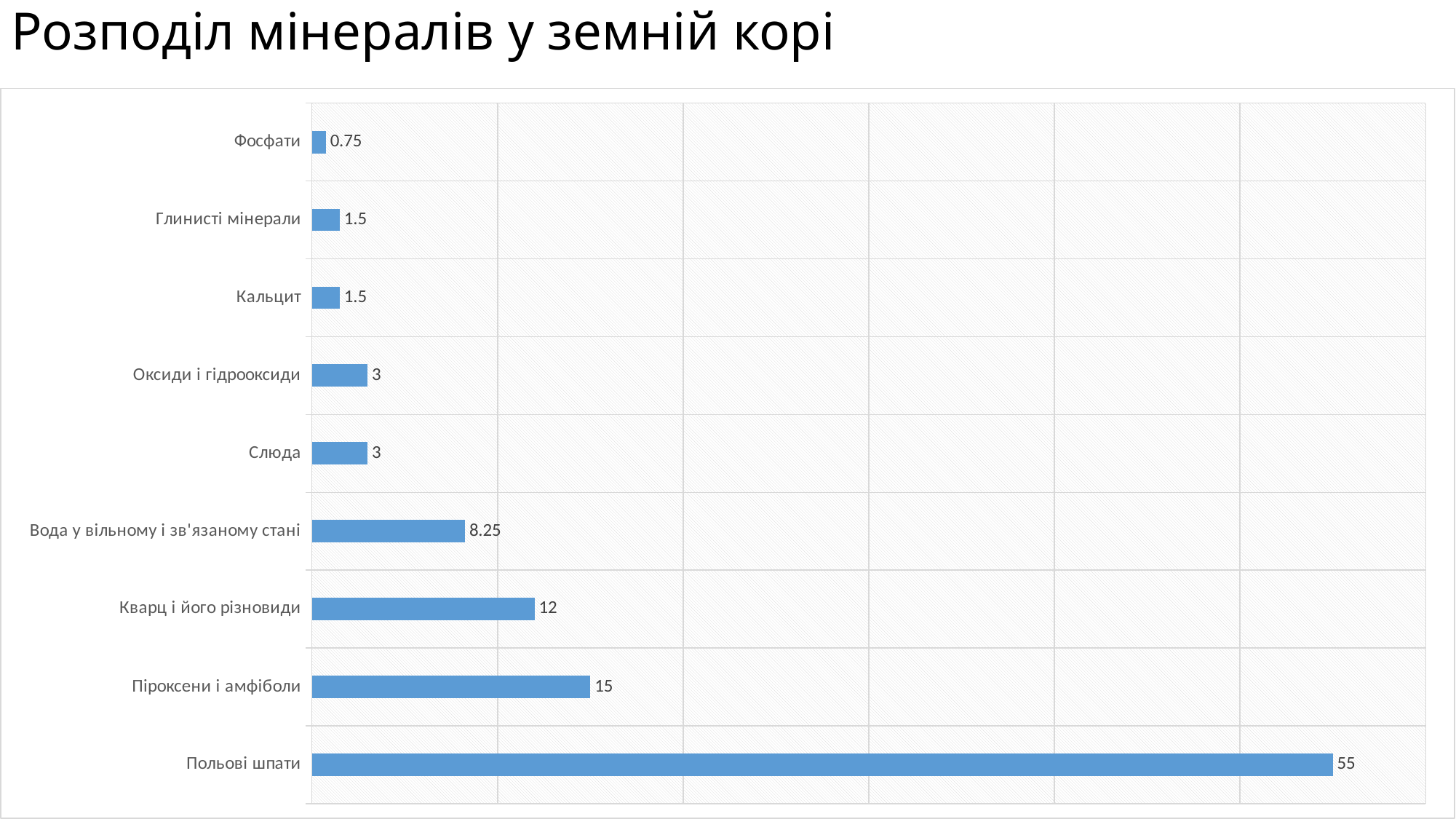
Which category has the highest value? Польові шпати Which category has the lowest value? Фосфати Which is larger, the value for Слюда or the value for Глинисті мінерали? Слюда What type of chart is shown on the slide? Bar chart What is the difference between the values for Польові шпати and Піроксени і амфіболи? 40 How many categories are shown in the chart? 9 What is the difference between the values for Кварц і його різновиди and Вода у вільному і зв'язаному стані? 3.75 What is the title of the slide? Розподіл мінералів у земній корі What is the value for Польові шпати? 55 What is the value for Фосфати? 0.75 What is the value for Кварц і його різновиди? 12 What is the value for Вода у вільному і зв'язаному стані? 8.25